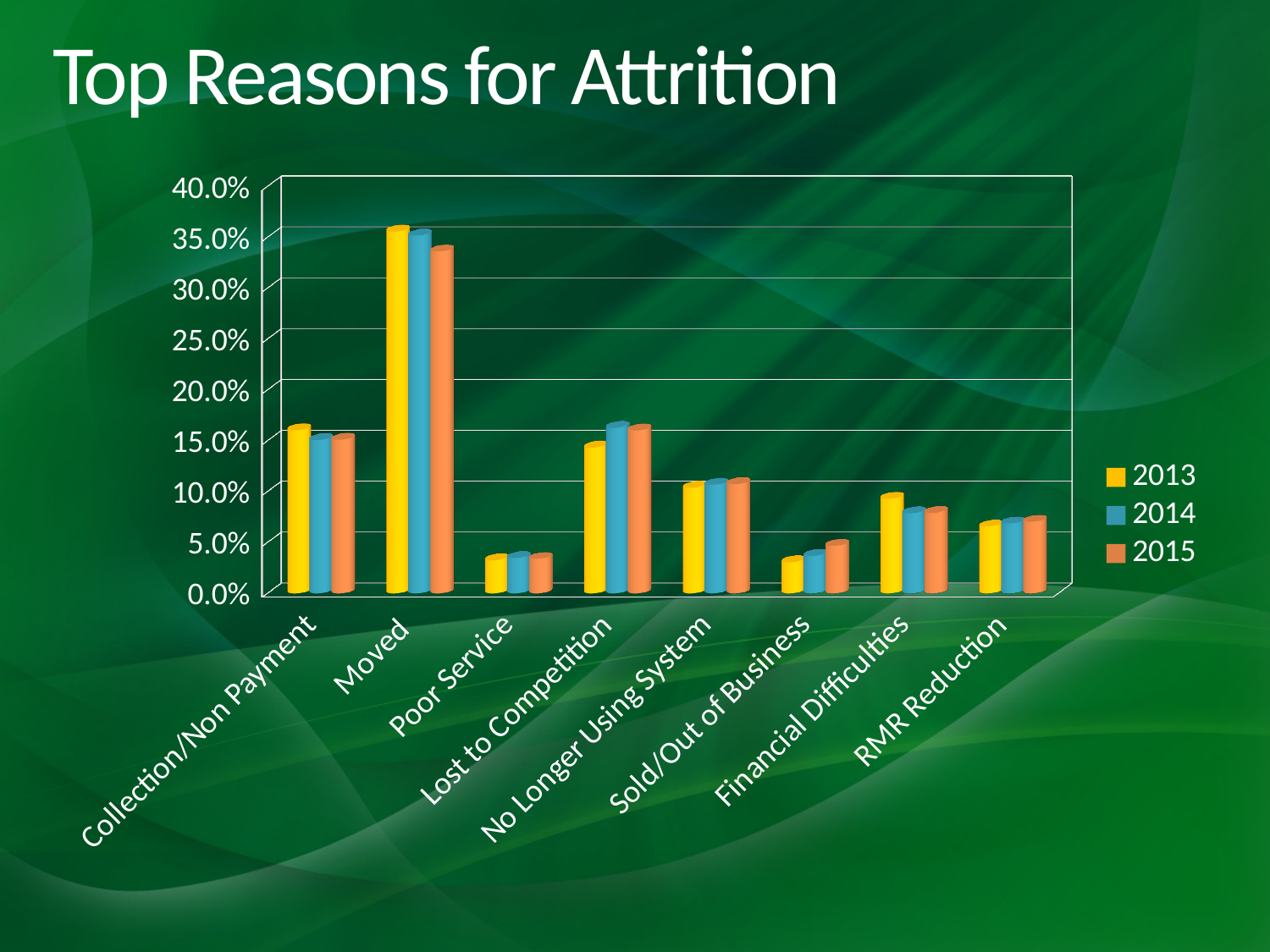
Which is larger for 2014: Lost to Competition or No Longer Using System? Lost to Competition Is the 2013 value for Moved greater or less than 30.0%? greater Is the 2015 value for Sold/Out of Business greater or less than 10.0%? less How many reason categories are shown on the x axis? 8 What is the title of the chart? Top Reasons for Attrition How many series does the legend list? 3 What kind of chart is shown on the slide? Bar chart Which is larger for 2013: Moved or Lost to Competition? Moved Is the 2015 value for Poor Service greater or less than 5.0%? less Which category has the lowest value for 2015? Poor Service Which category has the highest value for 2013? Moved